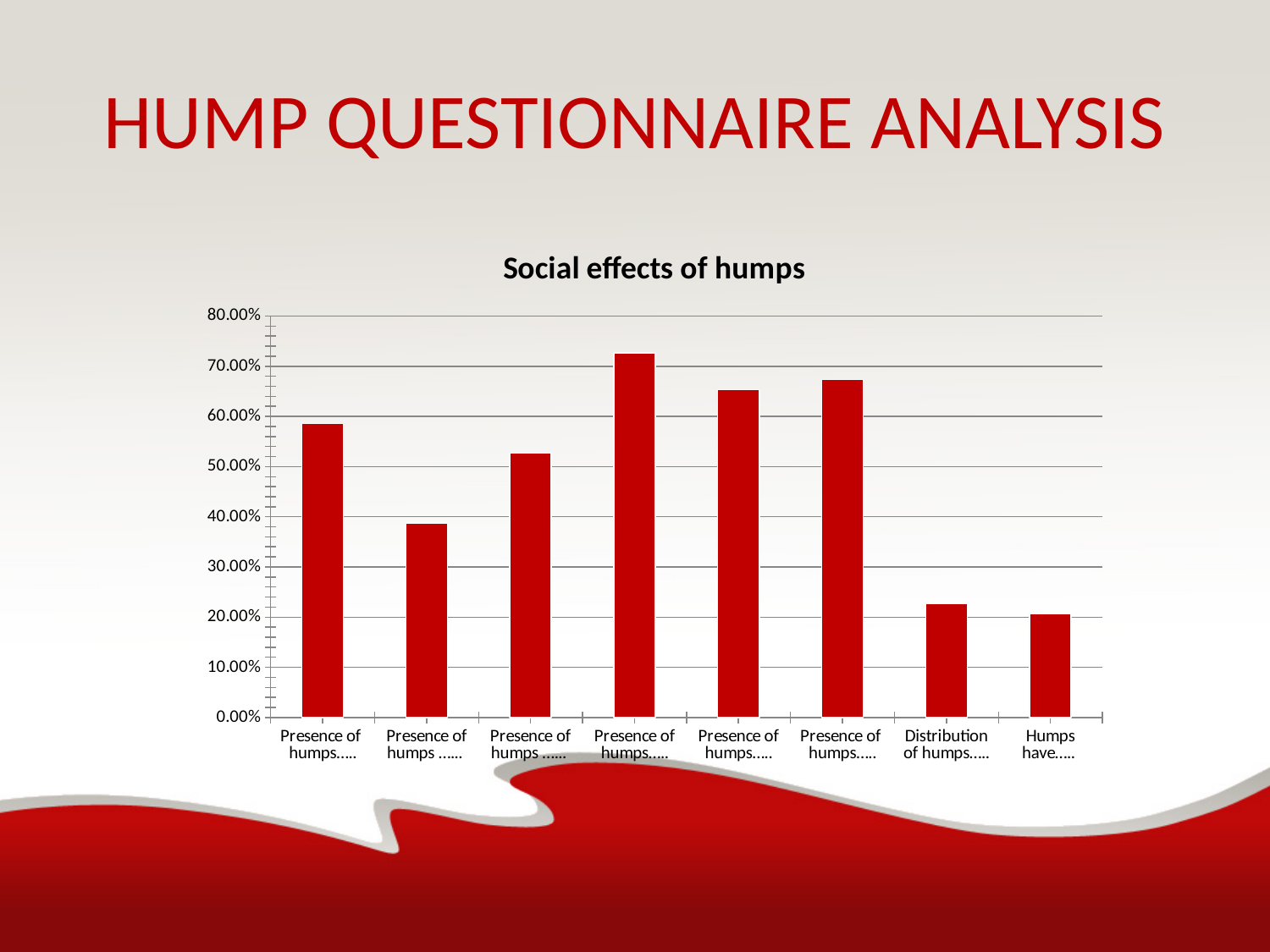
Is the value for the bar labelled 'Humps have.....' greater or less than 30.00%? less What is the title of the chart? Social effects of humps Which is larger, the second bar from the left or the fourth bar from the left? the fourth bar from the left Is the value for the second bar from the left greater or less than 30.00%? greater How many bars are plotted in the chart? 8 Is the value for the bar labelled 'Distribution of humps.....' greater or less than 30.00%? less What kind of chart is shown on the slide? bar chart Which bar is the highest in the chart? the fourth bar from the left What colour are the bars in the chart? red Which is larger, the first bar from the left or the third bar from the left? the first bar from the left